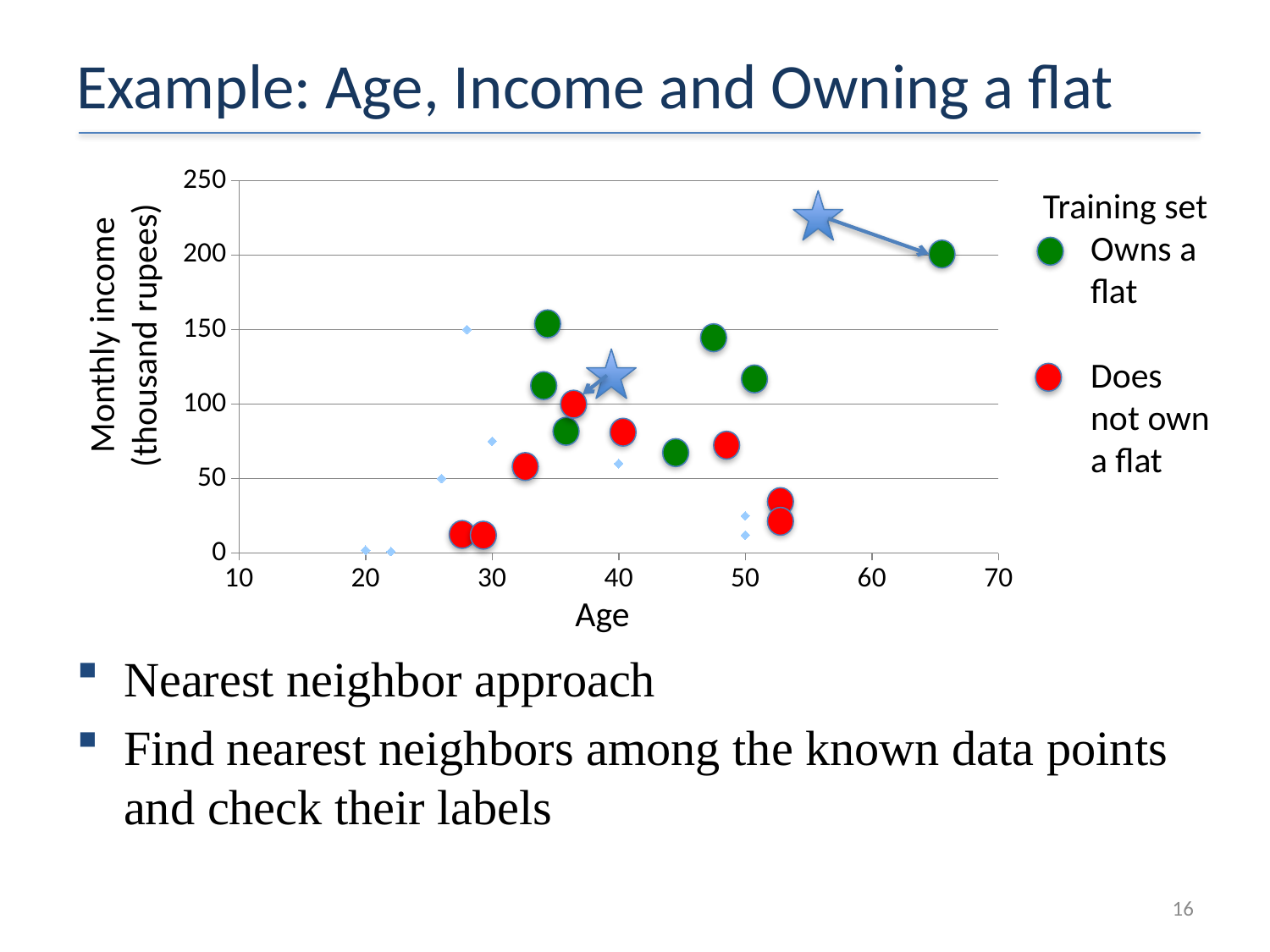
How many red 'Does not own a flat' points are plotted on the chart? 8 What is the title of the chart's horizontal axis? Age What kind of chart is shown on the slide? scatter chart Is the monthly income of the green point near age 47 greater or less than 100? greater What is the maximum value shown on the vertical axis? 250 How many categories does the legend list for the training set? 2 Which legend category is shown with green markers? Owns a flat Is the age of the rightmost green point greater or less than 60? greater Is the monthly income of the red points near age 28 greater or less than 50? less How many green 'Owns a flat' points are plotted on the chart? 7